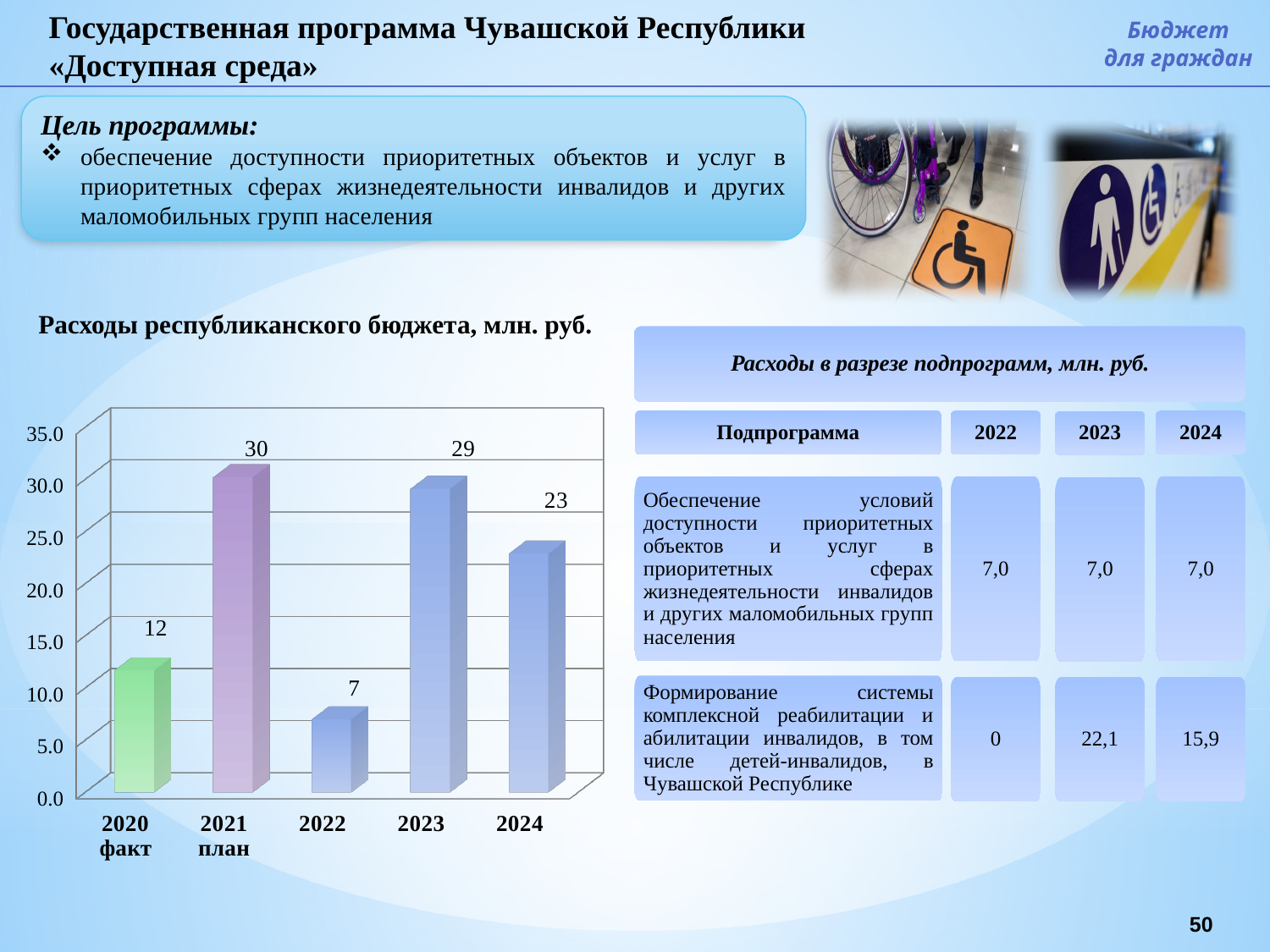
What is the value for 2020 факт in the chart? 12 What is the difference between the values for 2023 and 2022? 22 Which year has the lowest value in the chart? 2022 What is the value for 2021 план in the chart 'Расходы республиканского бюджета, млн. руб.'? 30 What is the title of the chart on the slide? Расходы республиканского бюджета, млн. руб. Is the value for 2023 greater or less than 25.0? greater Which year has the highest value in the chart? 2021 план Which is larger, the value for 2020 факт or the value for 2022? 2020 факт What is the value for 2024 in the chart? 23 What kind of chart is shown on the slide? bar chart What is the difference between the values for 2021 план and 2024? 7 How many categories are shown on the x axis of the chart? 5